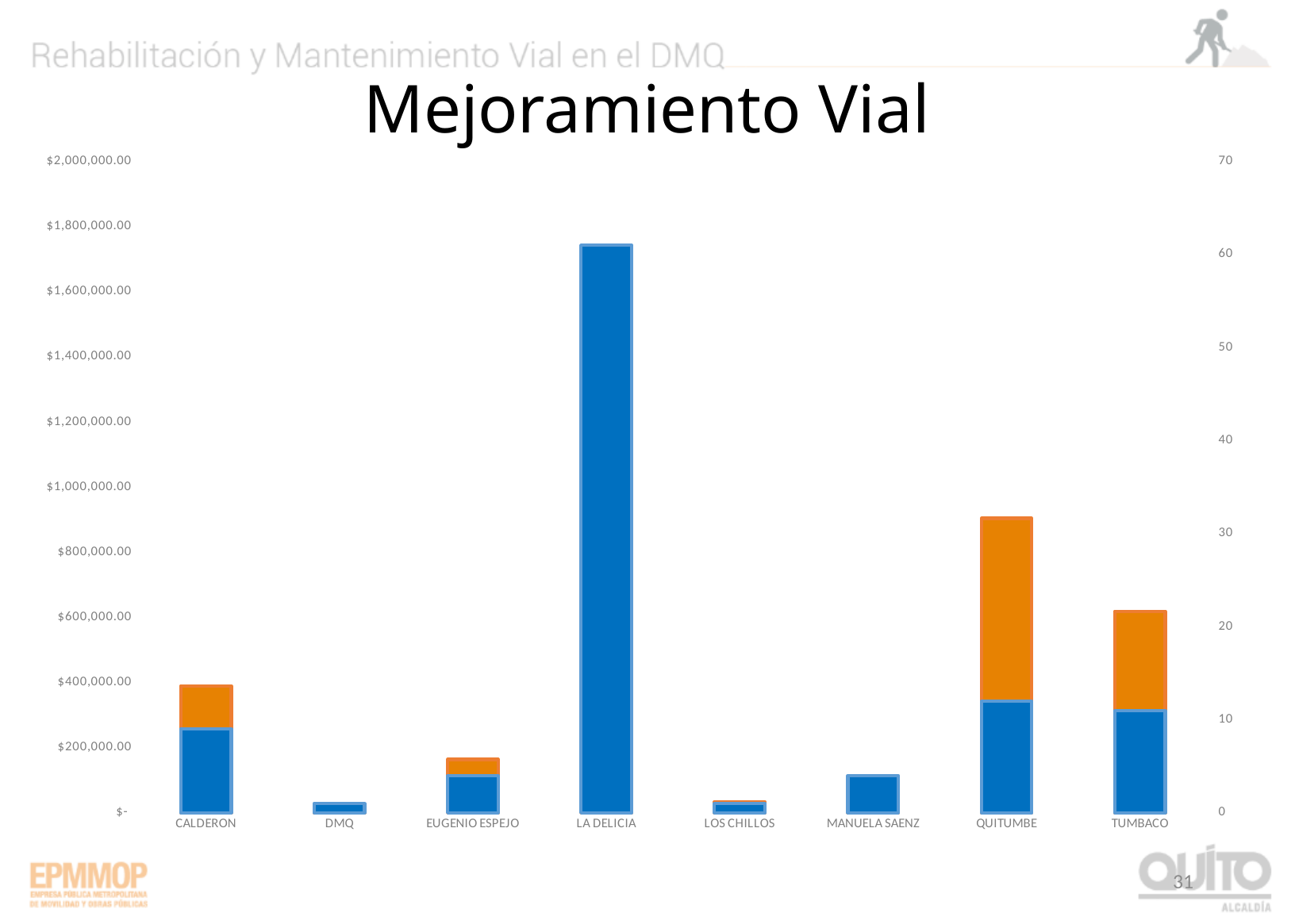
Which category has the tallest bar in the chart? LA DELICIA Is the total bar for LA DELICIA greater or less than $1,600,000.00? greater How many categories are shown on the x axis of the chart? 8 Is the total bar for TUMBACO greater or less than $400,000.00? greater What is the highest tick value shown on the right-hand axis of the chart? 70 Is the total bar for QUITUMBE greater or less than $1,000,000.00? less What kind of chart is shown on the slide? bar chart What is the title of the chart? Mejoramiento Vial Which has the taller total bar, QUITUMBE or TUMBACO? QUITUMBE Which has the taller total bar, CALDERON or EUGENIO ESPEJO? CALDERON